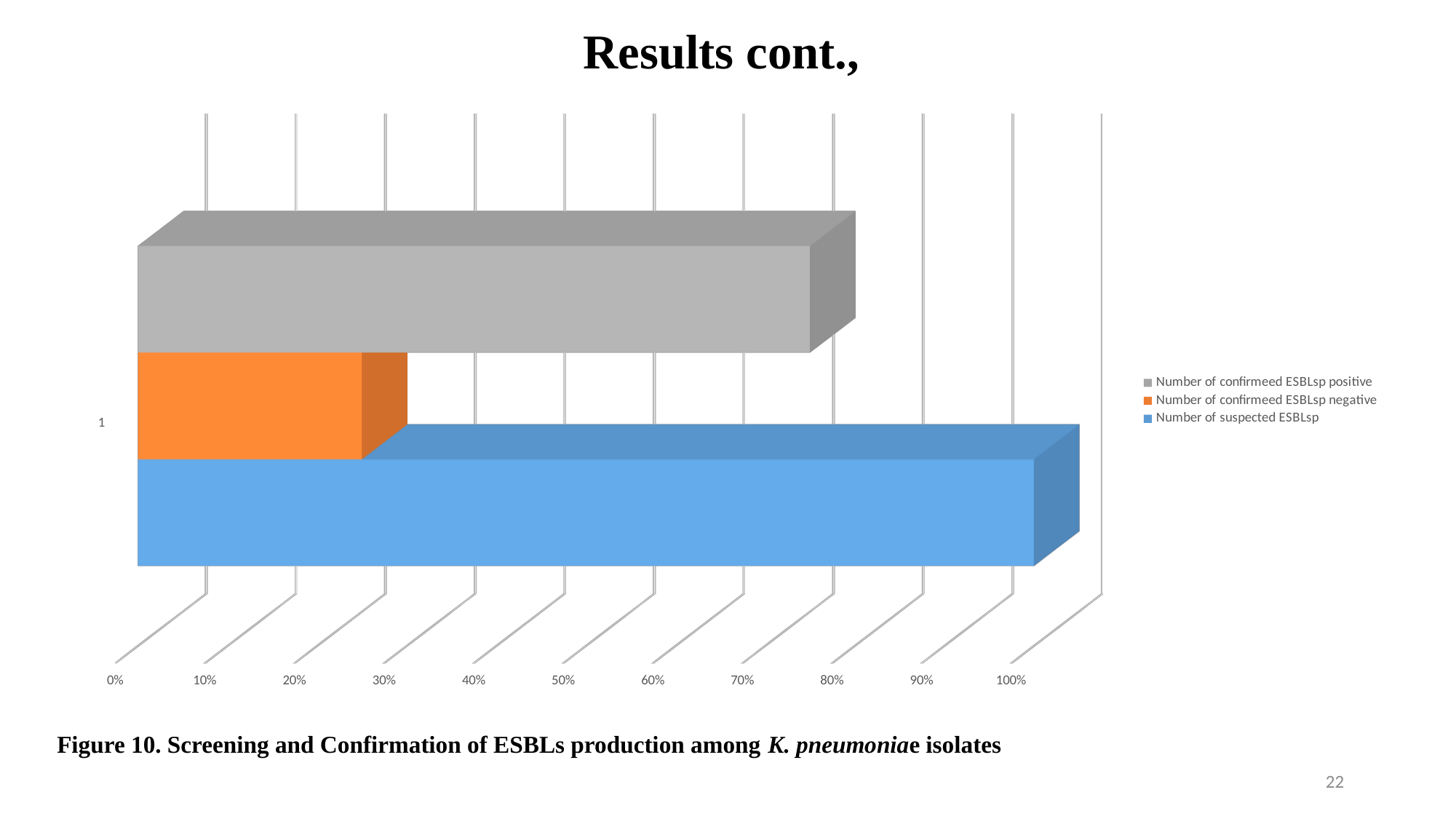
What is the highest percentage tick shown on the horizontal axis? 100% Is the value for Number of suspected ESBLsp greater or less than 90%? greater Which is larger, the bar for confirmed ESBLsp positive or the bar for confirmed ESBLsp negative? Number of confirmeed ESBLsp positive Which series has the shortest bar? Number of confirmeed ESBLsp negative How many series does the legend list? 3 What kind of chart is shown on the slide? Bar chart Is the value for Number of confirmeed ESBLsp negative greater or less than 20%? greater Is the value for Number of confirmeed ESBLsp positive greater or less than 70%? greater Which series has the longest bar? Number of suspected ESBLsp How many categories are plotted on the vertical axis? 1 What colour is the bar for Number of suspected ESBLsp? Blue